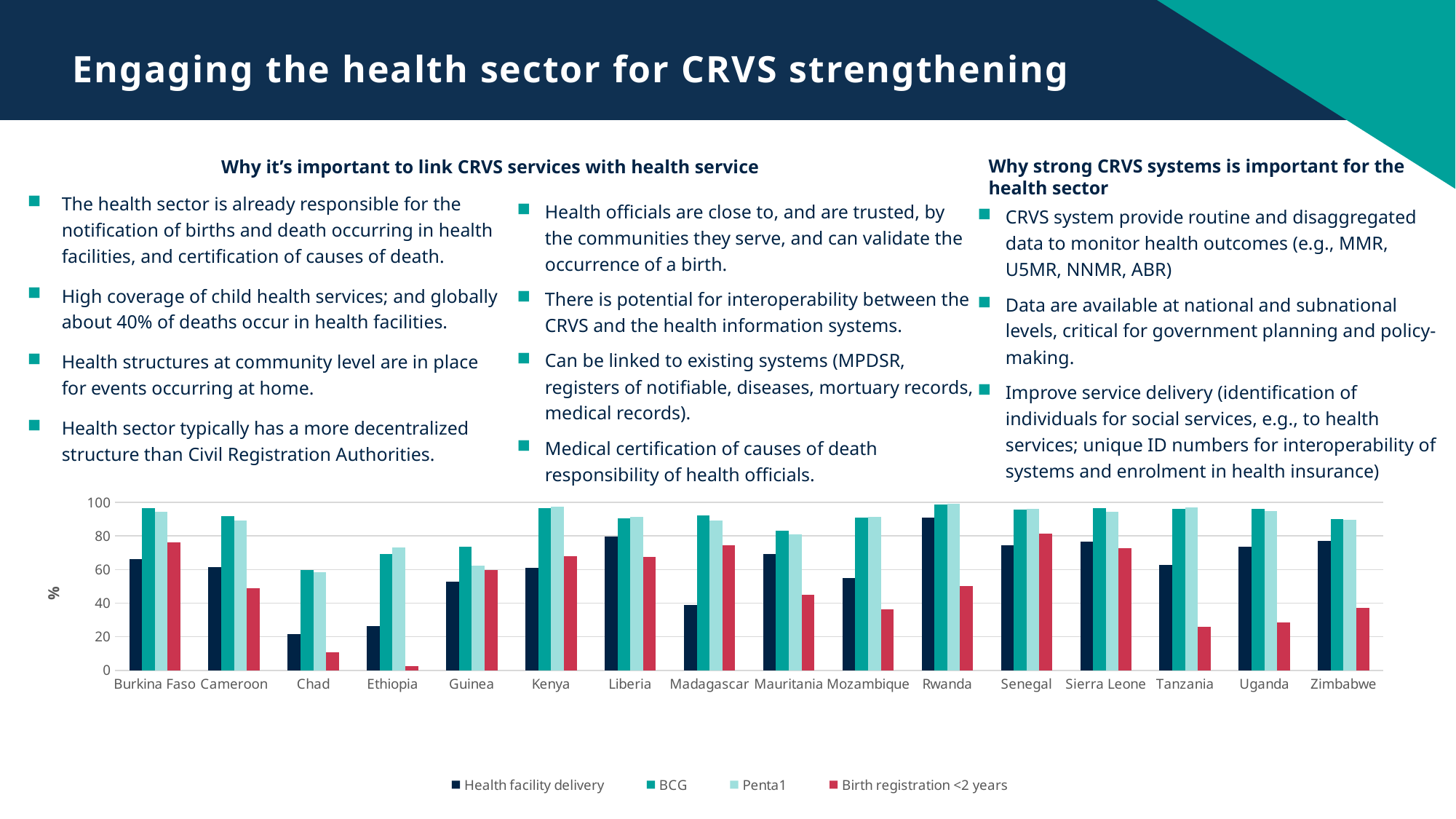
Which country has the lowest value for Birth registration <2 years? Ethiopia What kind of chart is shown at the bottom of the slide? Bar chart What is the label on the y axis of the chart? % In Chad, which is larger: the Health facility delivery value or the BCG value? BCG Which country has the lowest value for Health facility delivery? Chad Is the value for Birth registration <2 years in Uganda greater or less than 40? less In Kenya, which is larger: the BCG value or the Birth registration <2 years value? BCG Is the value for Birth registration <2 years in Chad greater or less than 20? less Which country has the highest value for Health facility delivery? Rwanda Is the value for Health facility delivery in Rwanda greater or less than 80? greater How many countries are shown on the x axis of the chart? 16 How many series does the chart legend list? 4